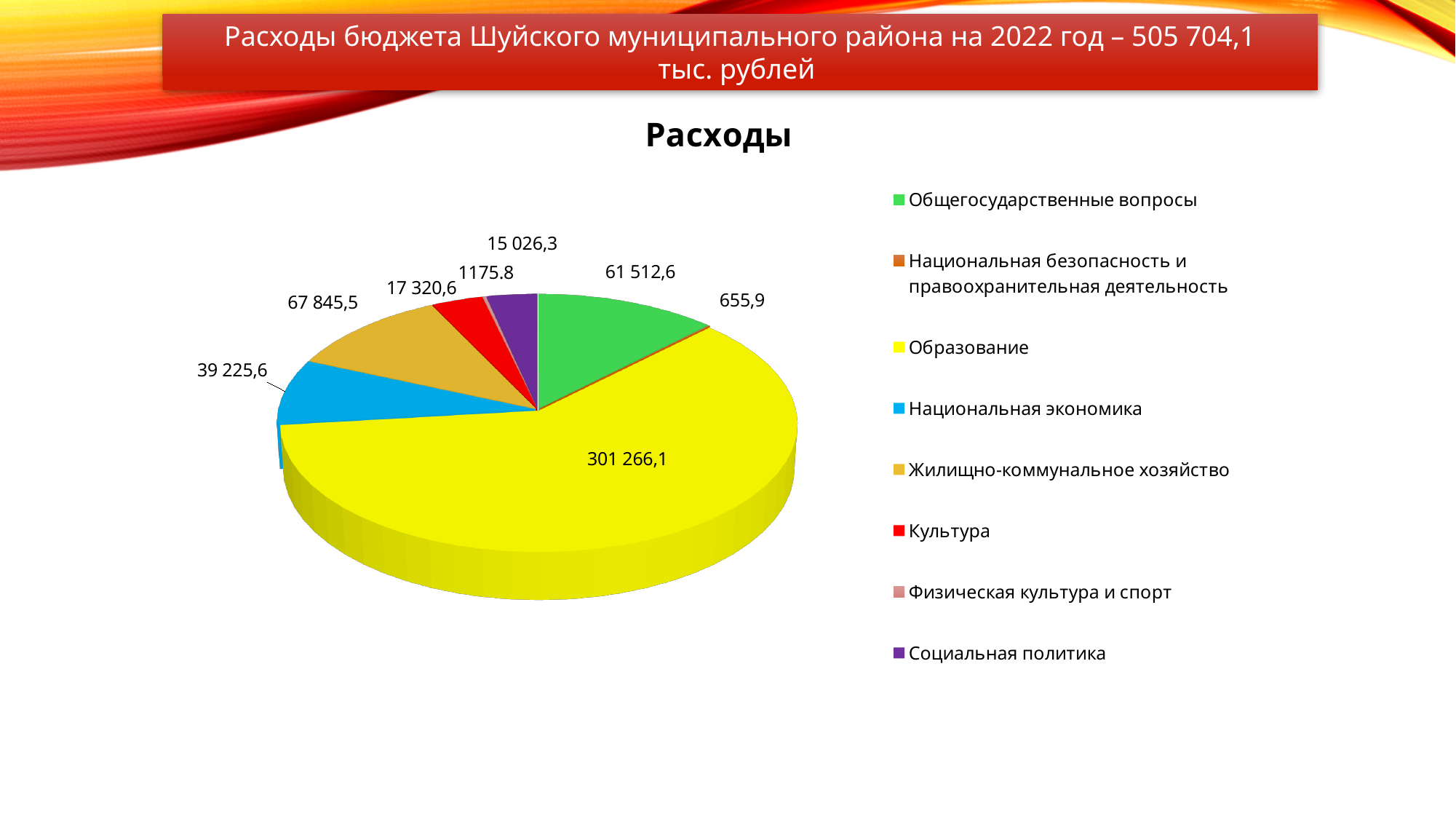
Which is larger: Общегосударственные вопросы or Жилищно-коммунальное хозяйство? Жилищно-коммунальное хозяйство What is the value for Национальная экономика in the pie chart? 39 225,6 Which category has the smallest slice in the pie chart? Национальная безопасность и правоохранительная деятельность What colour is the slice for Образование? Yellow What is the value for Жилищно-коммунальное хозяйство in the pie chart? 67 845,5 What is the value for Социальная политика in the pie chart? 15 026,3 What is the difference between the values for Национальная экономика and Культура? 21 905,0 What kind of chart is shown on the slide? Pie chart What is the value for Образование in the pie chart? 301 266,1 How many categories does the pie chart show? 8 What is the difference between the values for Жилищно-коммунальное хозяйство and Общегосударственные вопросы? 6 332,9 Which category has the largest slice in the pie chart? Образование